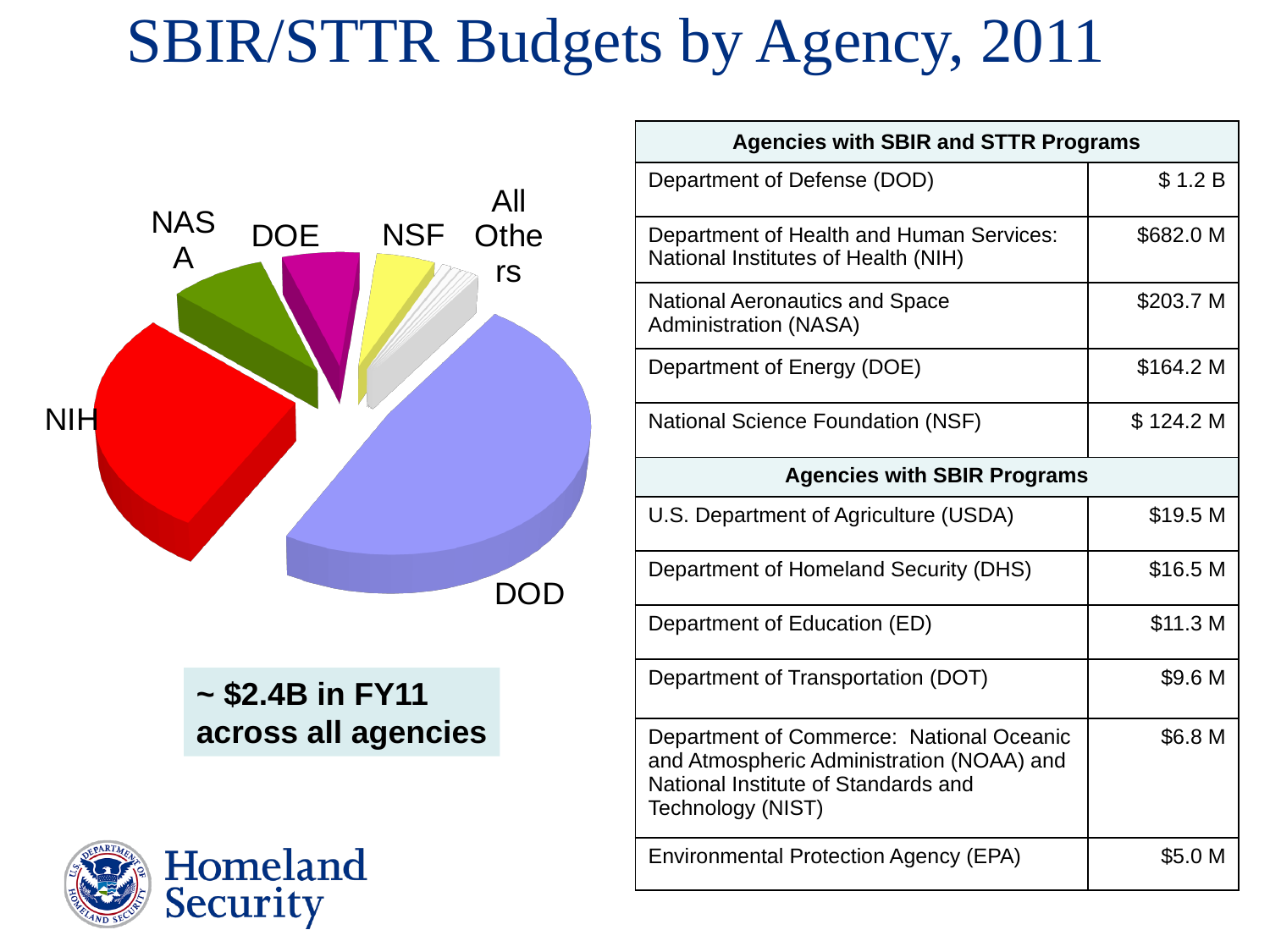
Which slice is larger in the pie chart, NASA or DOE? NASA Which slice is larger in the pie chart, DOD or NIH? DOD What kind of chart is shown on the slide? pie chart According to the table, what is the SBIR/STTR budget for NASA? $203.7 M Which agency has the largest slice in the pie chart? DOD According to the table, what is the SBIR/STTR budget for the Department of Defense (DOD)? $ 1.2 B What colour is the DOD slice in the pie chart? light purple How many labeled slices does the pie chart have? 6 Using the table values, how much larger is the NASA budget than the DOE budget? $39.5 M According to the table, what is the SBIR/STTR budget for the National Science Foundation (NSF)? $ 124.2 M Which slice is larger in the pie chart, NIH or NASA? NIH What colour is the NIH slice in the pie chart? red